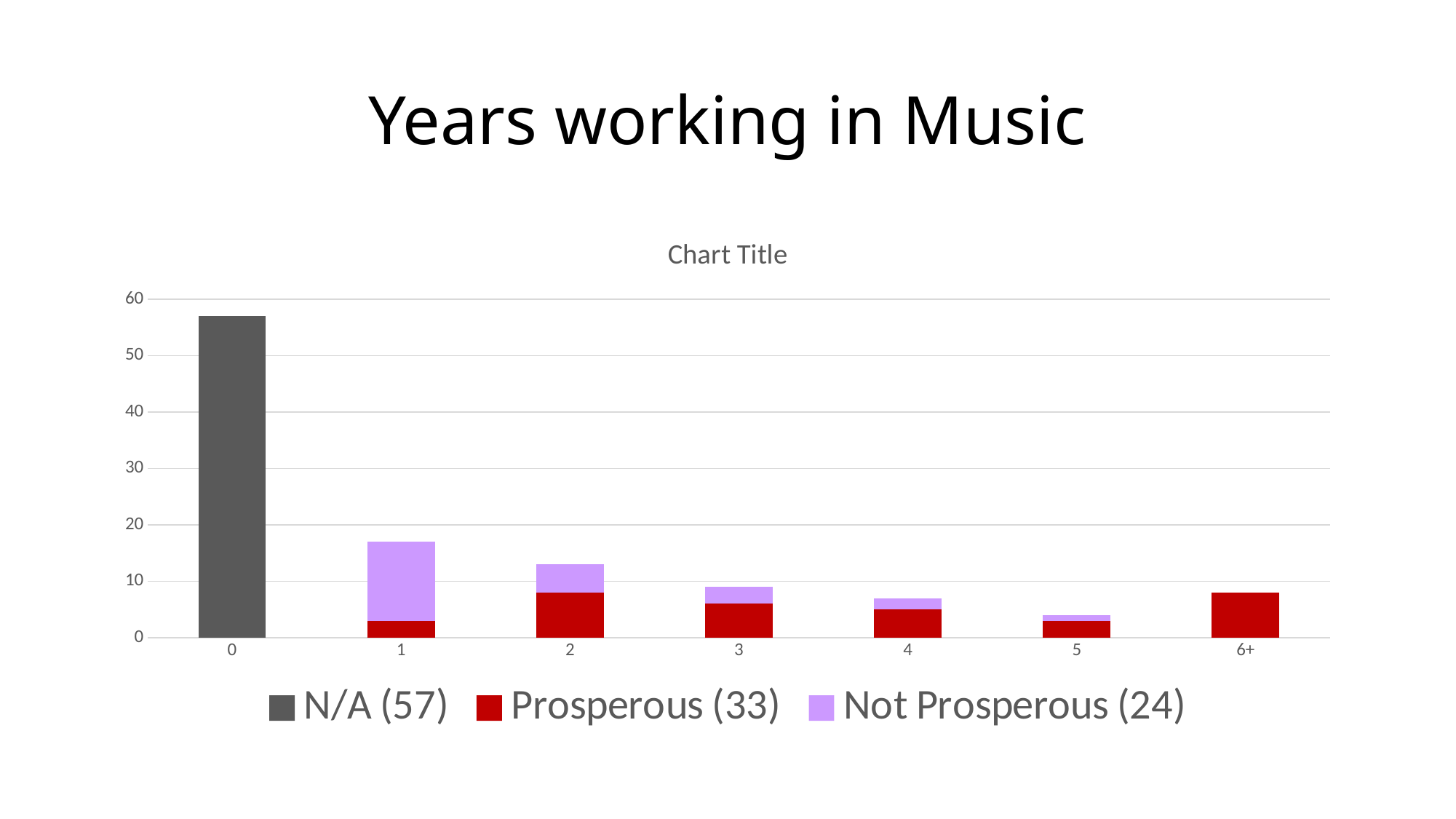
What kind of chart is shown on the slide? Stacked bar chart What colour represents the N/A series in the legend? Grey Which is larger, the Not Prosperous value for category 1 or for category 2? Category 1 Is the Prosperous value for category 6+ greater or less than 10? less Is the total bar for category 1 greater or less than 10? greater Which is larger, the total bar for category 1 or the total bar for category 2? Category 1 Is the value for N/A at category 0 greater or less than 50? greater How many series does the legend list? 3 Which category has the shortest total bar? 5 Which category has the tallest bar? 0 How many categories are shown on the x axis? 7